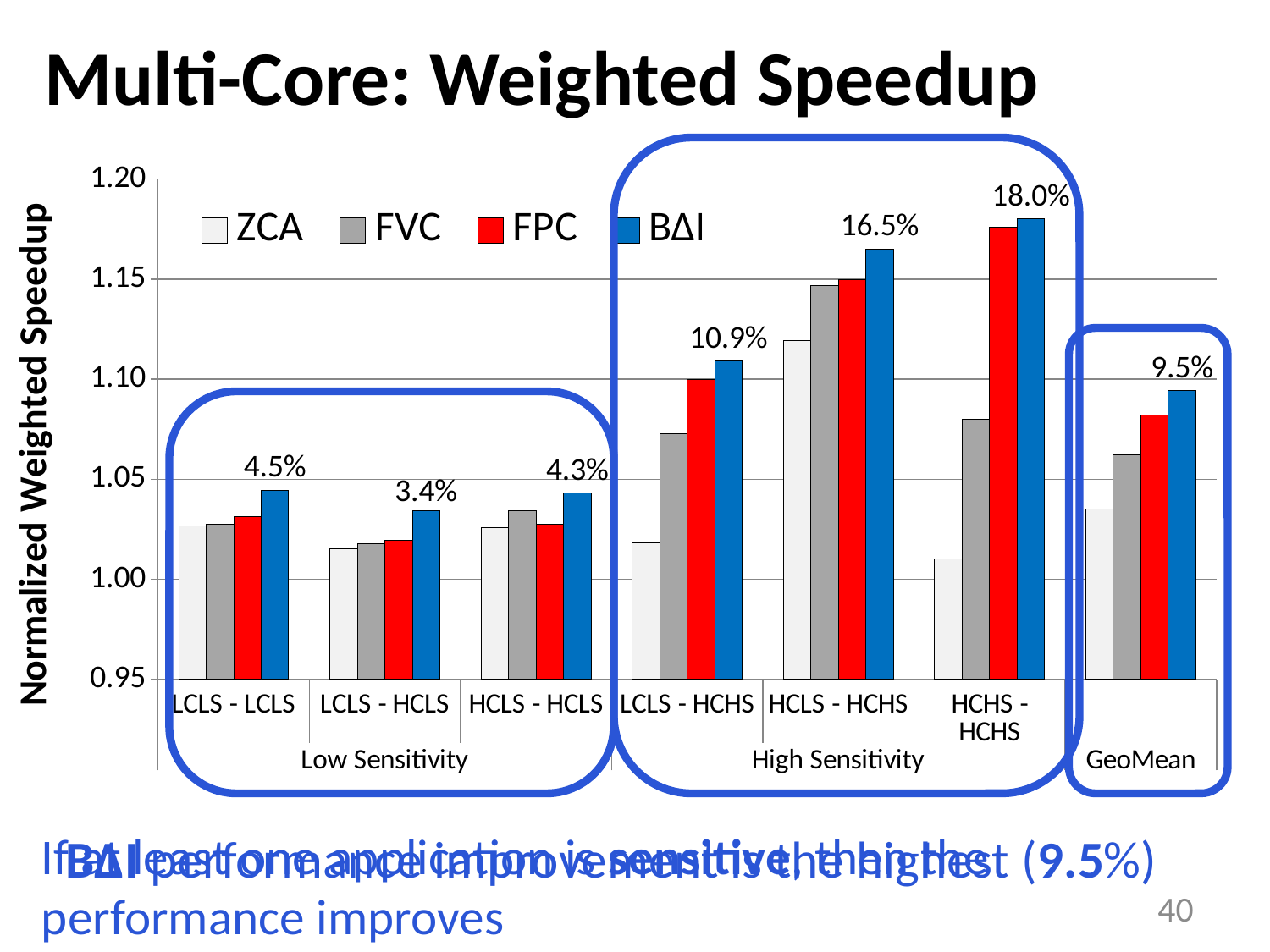
What percentage label is shown above the BΔI bar for GeoMean? 9.5% How many workload categories are plotted along the x axis? 7 For HCLS - HCHS, which is larger, the ZCA bar or the FVC bar? FVC Which category has the lowest BΔI bar? LCLS - HCLS What kind of chart is shown on the slide? bar chart What percentage label is shown above the BΔI bar for HCHS - HCHS? 18.0% How many series does the legend list? 4 Is the FVC value for HCHS - HCHS greater or less than 1.10? less Is the BΔI value for HCHS - HCHS greater or less than 1.15? greater Which category has the highest BΔI bar? HCHS - HCHS What is the title of the y axis? Normalized Weighted Speedup What percentage label is shown above the BΔI bar for LCLS - HCLS? 3.4%